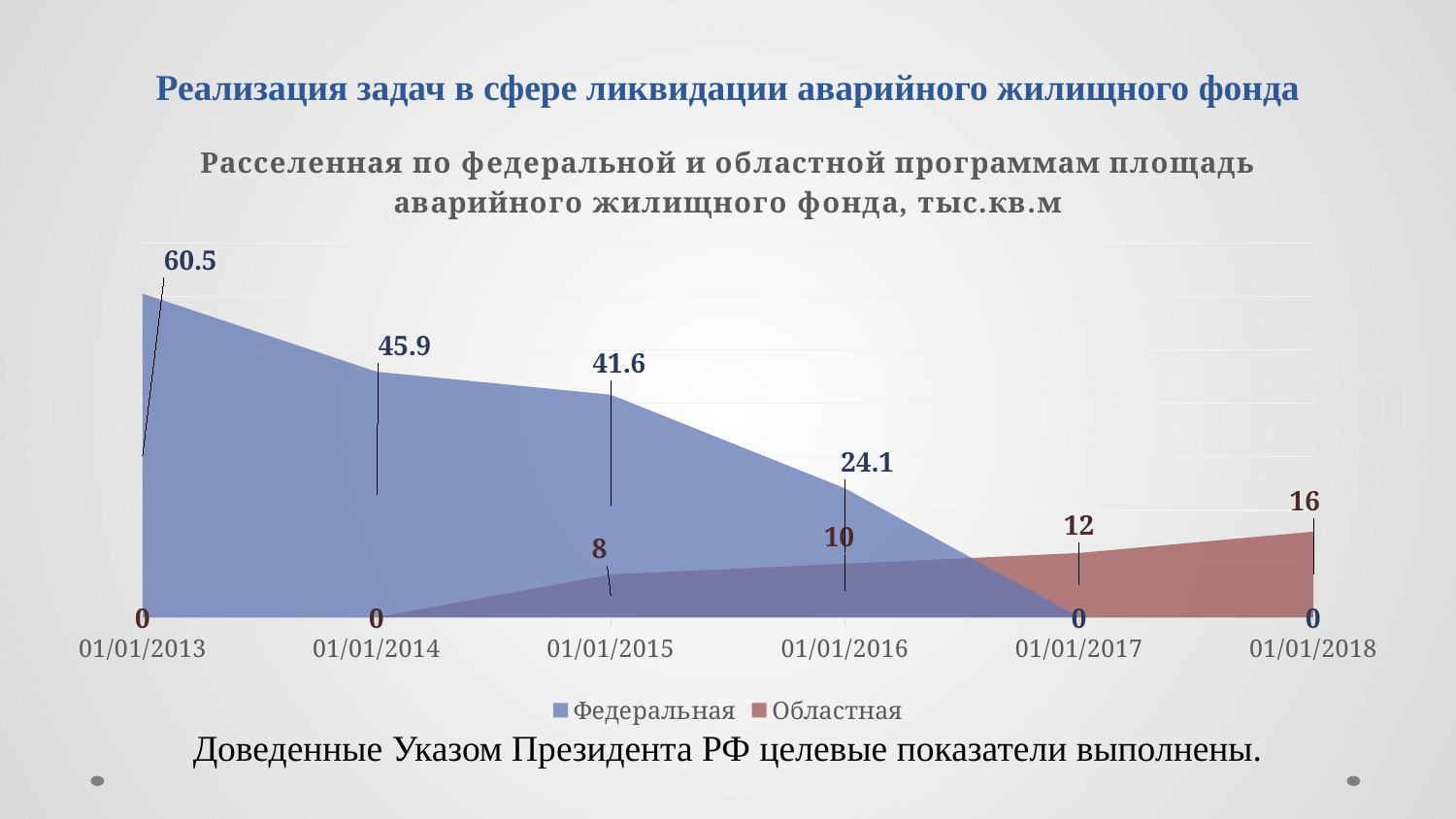
What kind of chart is shown on the slide? Area chart What is the value of the Федеральная series on 01/01/2016? 24.1 How many series does the legend list? 2 What is the value of the Областная series on 01/01/2018? 16 What is the value of the Федеральная series on 01/01/2013? 60.5 Does the Федеральная series rise or fall from 01/01/2013 to 01/01/2017? Fall How many dates are shown on the x axis? 6 On which date is the Областная series highest? 01/01/2018 What is the value of the Областная series on 01/01/2015? 8 On which date is the Федеральная series highest? 01/01/2013 What is the difference between the Федеральная values on 01/01/2013 and 01/01/2014? 14.6 Which is larger on 01/01/2016: the Федеральная value or the Областная value? Федеральная